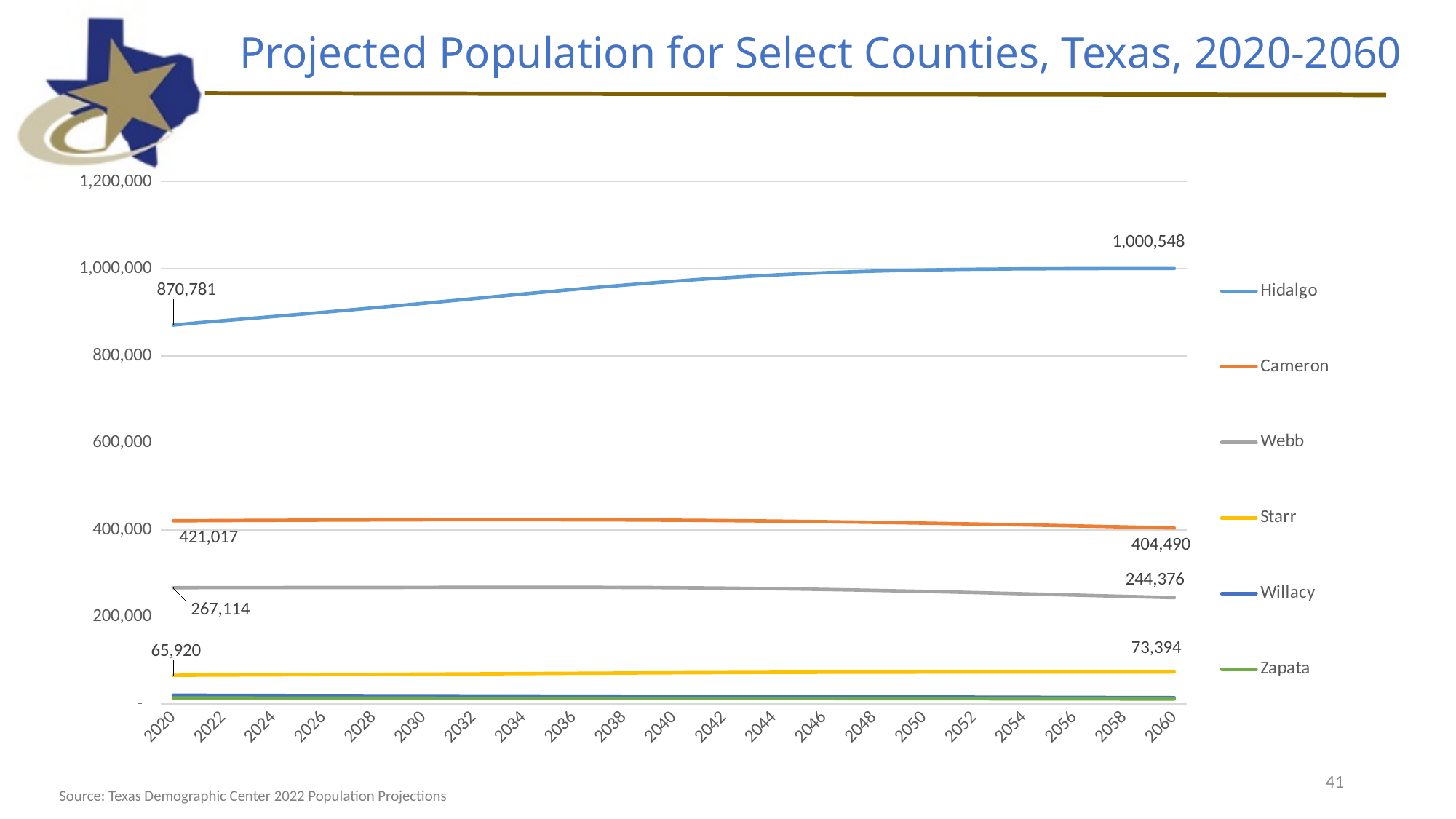
Which is larger: Webb County's projected population in 2020 or in 2060? 2020 How many counties are listed in the legend? 6 Does Hidalgo County's projected population rise or fall from 2020 to 2060? rise What is the difference between Cameron County's projected population in 2020 and in 2060? 16,527 What is the projected population of Webb County in 2020? 267,114 What is the projected population of Cameron County in 2060? 404,490 What is the projected population of Hidalgo County in 2060? 1,000,548 What is the projected population of Starr County in 2060? 73,394 By how much does Hidalgo County's projected population increase from 2020 to 2060? 129,767 What is the projected population of Hidalgo County in 2020? 870,781 Which county has the highest projected population in 2060? Hidalgo What type of chart is shown on the slide? line chart